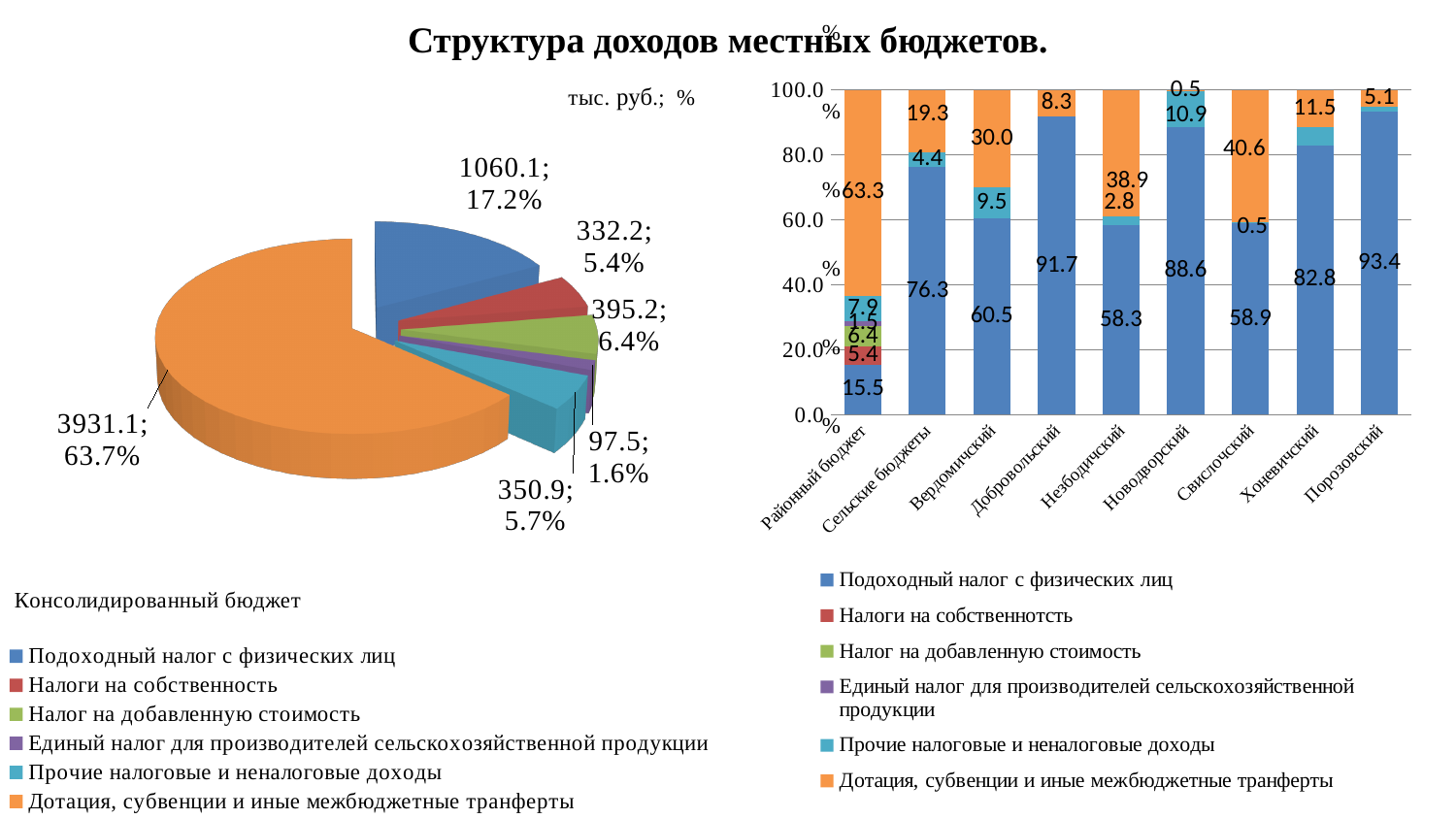
On the stacked bar chart (right), which category has the lowest value for Подоходный налог с физических лиц (blue)? Районный бюджет On the pie chart (left), how many slices are there? 6 On the pie chart (left), what share is shown for the slice labelled 1060.1? 17.2% On the pie chart (left), which slice has the smallest share? 97.5; 1.6% On the stacked bar chart (right), how many categories are shown on the x axis? 9 On the stacked bar chart (right), what is the value of the orange segment (Дотация, субвенции и иные межбюджетные трансферты) for Районный бюджет? 63.3 On the stacked bar chart (right), how many series does the legend list? 6 On the stacked bar chart (right), what is the value of the orange segment for Свислочский? 40.6 On the pie chart (left), what value and share are shown for the largest slice? 3931.1; 63.7% On the stacked bar chart (right), what is the value of the blue segment (Подоходный налог с физических лиц) for Порозовский? 93.4 On the stacked bar chart (right), what is the difference between the blue segment values for Добровольский and Вердомичский? 31.2 On the stacked bar chart (right), which category has the highest value for Подоходный налог с физических лиц (blue)? Порозовский